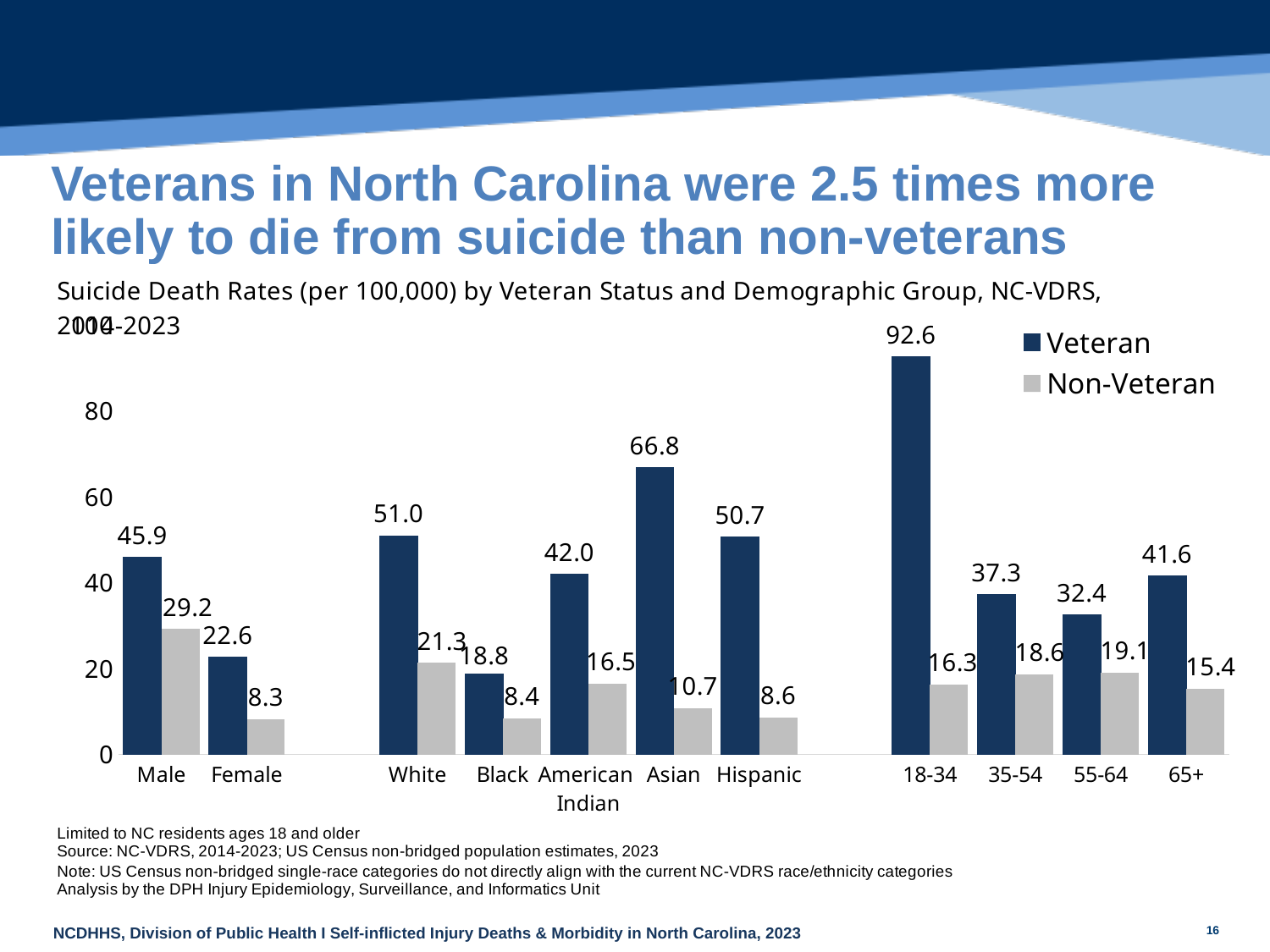
Which colour represents the Non-Veteran series in the chart? Gray What is the Veteran suicide death rate for the 18-34 age group? 92.6 What type of chart is shown on the slide? Bar chart Which is larger: the Veteran rate for White or the Veteran rate for Hispanic? White What is the Non-Veteran suicide death rate for Males? 29.2 Which demographic group has the lowest Veteran suicide death rate? Black How many demographic groups are shown on the x axis of the chart? 11 What is the Veteran suicide death rate for the Asian group? 66.8 How many series does the chart legend list? 2 Is the Veteran suicide death rate for the 35-54 age group greater or less than 40? less What is the difference between the Veteran and Non-Veteran suicide death rates for Females? 14.3 Which demographic group has the highest Veteran suicide death rate? 18-34